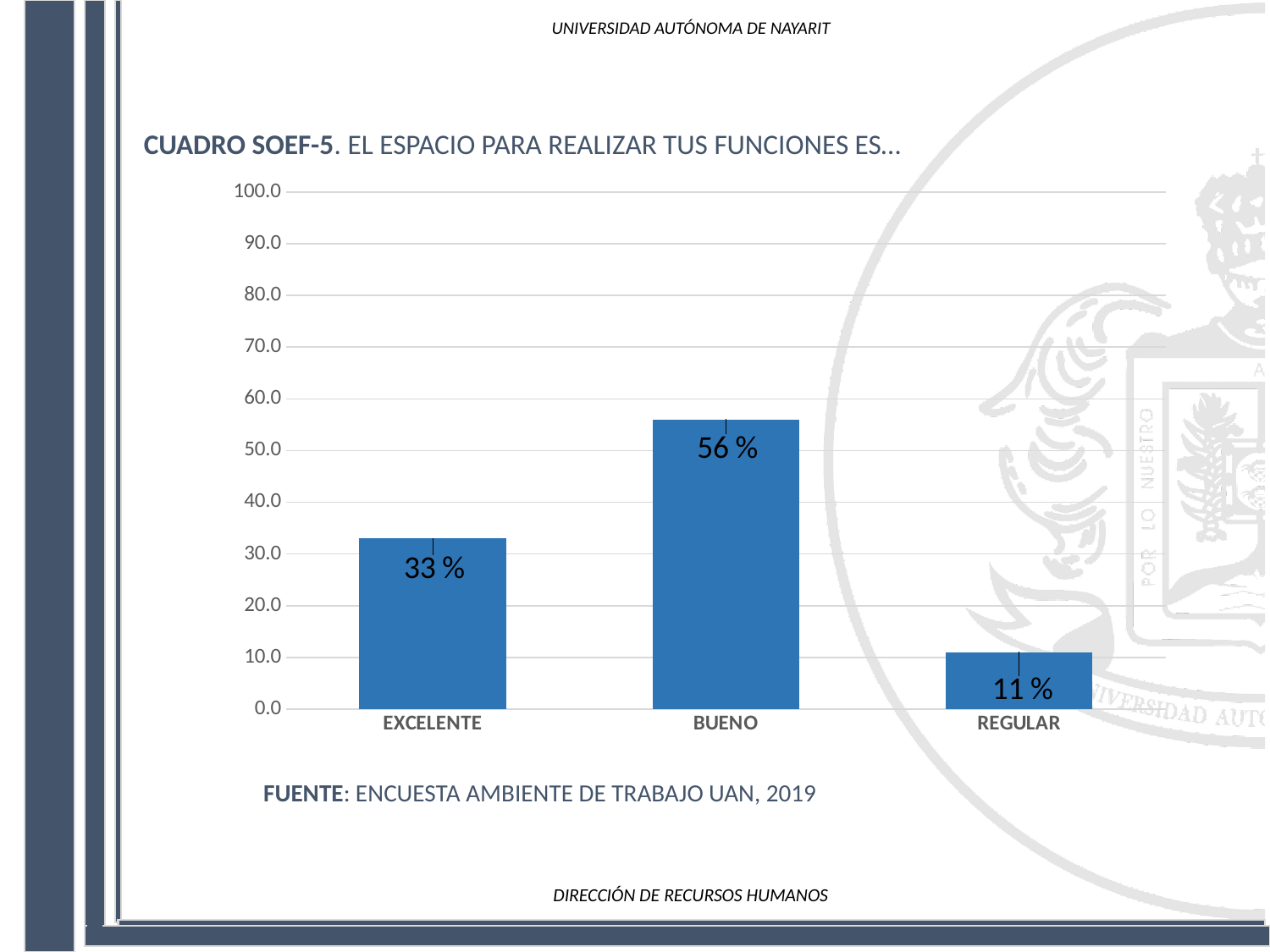
Which category has the highest value? BUENO Is the value for BUENO greater or less than 50.0? greater What is the difference between the values for EXCELENTE and REGULAR? 22 % What is the source cited below the chart? ENCUESTA AMBIENTE DE TRABAJO UAN, 2019 How many categories are shown on the x axis? 3 What kind of chart is shown on the slide? bar chart What is the value for EXCELENTE? 33 % What is the value for BUENO? 56 % Which category has the lowest value? REGULAR Which is larger, the value for EXCELENTE or the value for REGULAR? EXCELENTE What is the value for REGULAR? 11 % What is the difference between the values for BUENO and EXCELENTE? 23 %